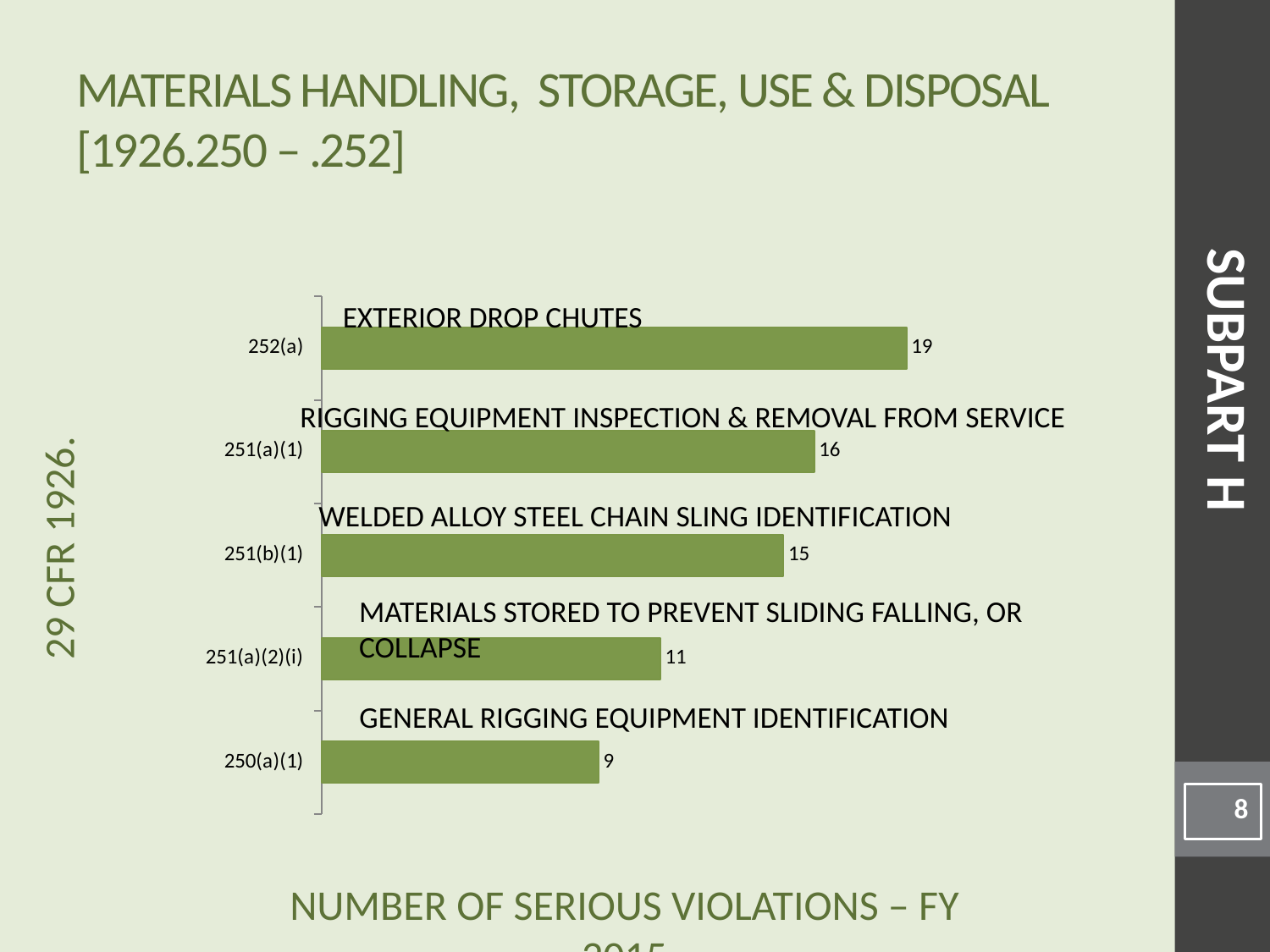
What is the number of serious violations for 251(b)(1)? 15 Which standard has the highest number of serious violations? 252(a) What is the number of serious violations for 251(a)(2)(i)? 11 What is the number of serious violations for 251(a)(1)? 16 What is the number of serious violations for 252(a)? 19 Which standard has the lowest number of serious violations? 250(a)(1) What is the difference in serious violations between 252(a) and 250(a)(1)? 10 Which has more serious violations, 251(a)(1) or 251(b)(1)? 251(a)(1) What type of chart is shown on the slide? Bar chart What description is given for the bar labelled 252(a)? EXTERIOR DROP CHUTES What is the number of serious violations for 250(a)(1)? 9 How many standards (bars) are shown in the chart? 5